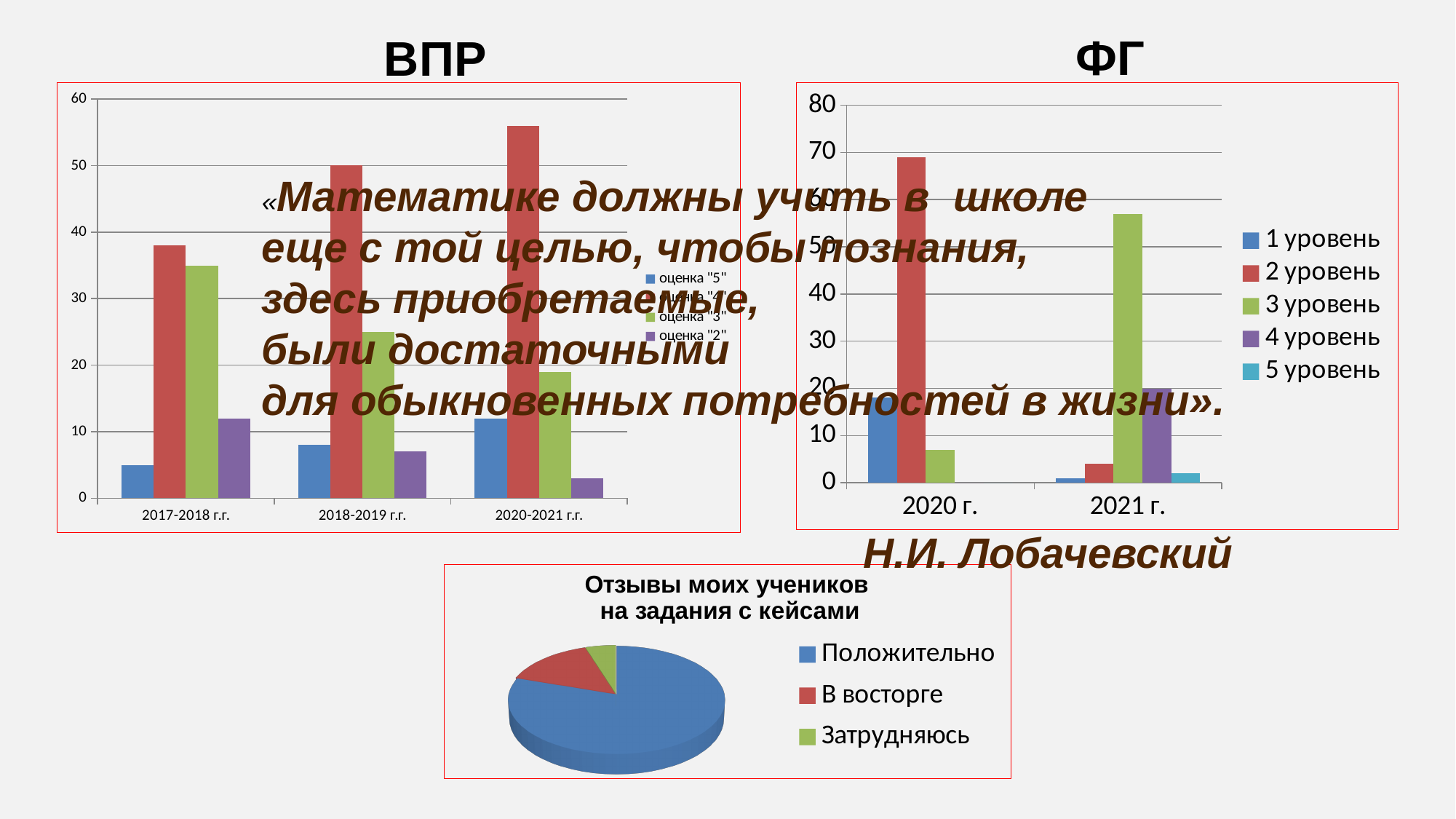
In the ВПР chart, does the value for оценка "2" rise or fall from 2017-2018 г.г. to 2020-2021 г.г.? falls In the ФГ chart, is the value for 2 уровень in 2020 г. greater or less than 60? greater In the ВПР chart, for 2017-2018 г.г., which is larger: оценка "3" or оценка "2"? оценка "3" In the pie chart "Отзывы моих учеников на задания с кейсами", which category has the largest slice? Положительно In the ВПР chart, which school year has the highest value for оценка "4"? 2020-2021 г.г. In the ВПР chart, is the value for оценка "4" in 2020-2021 г.г. greater or less than 50? greater How many school-year categories does the ВПР chart show? 3 In the ВПР chart, does the value for оценка "4" rise or fall from 2017-2018 г.г. to 2020-2021 г.г.? rises In the ФГ chart, which level has the highest value for 2020 г.? 2 уровень What kind of chart is the ВПР chart? bar chart How many series does the legend of the ВПР chart list? 4 How many series does the legend of the ФГ chart list? 5